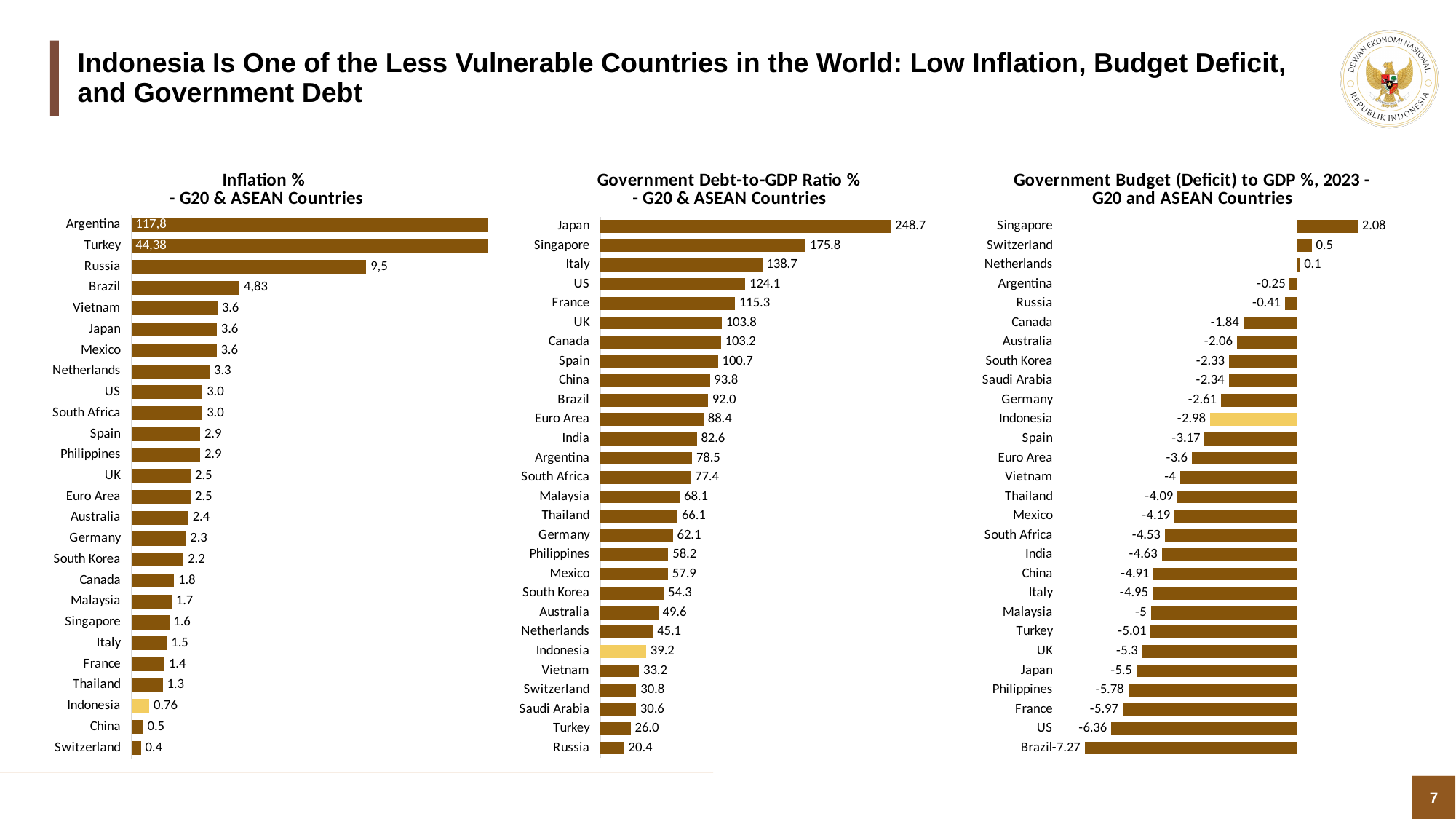
In the Government Budget (Deficit) to GDP % chart, which country has the lowest value? Brazil How many countries are shown in the Government Debt-to-GDP Ratio % chart? 28 In the Government Budget (Deficit) to GDP % chart, which country has the highest value? Singapore In the Government Budget (Deficit) to GDP % chart, what is the value for Indonesia? -2.98 What type of chart is the Inflation % chart? Bar chart In the Government Debt-to-GDP Ratio % chart, which is larger, the value for Italy or the value for US? Italy In the Government Debt-to-GDP Ratio % chart, what is the difference between Japan and Indonesia? 209.5 In the Government Debt-to-GDP Ratio % chart, what is the value for Indonesia? 39.2 In the Inflation % chart, which country has the lowest inflation? Switzerland In the Inflation % chart, which country has the highest inflation? Argentina In the Government Debt-to-GDP Ratio % chart, which country has the highest ratio? Japan In the Inflation % chart, what is the value for Indonesia? 0.76